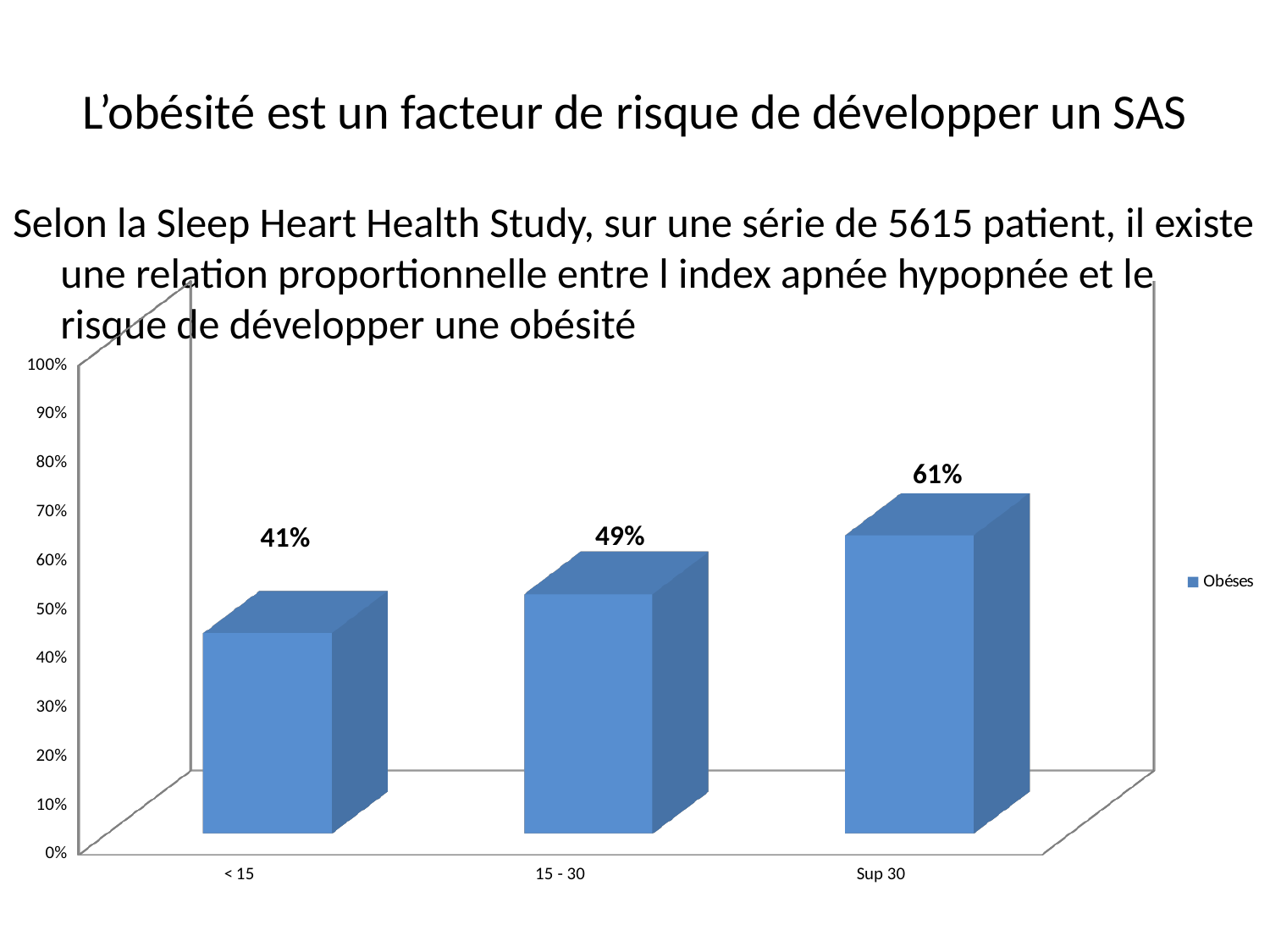
What is the value for the 'Sup 30' category? 61% What is the difference between the values for '15 - 30' and '< 15'? 8% Which category has the lowest value? < 15 How many categories are shown on the x axis? 3 Do the values rise or fall from '< 15' to 'Sup 30'? rise What is the value for the '15 - 30' category? 49% What kind of chart is shown on the slide? bar chart How many series does the legend list? 1 What is the value for the '< 15' category? 41% What is the difference between the values for 'Sup 30' and '< 15'? 20% Which category has the highest value? Sup 30 Which is larger, the value for '15 - 30' or the value for 'Sup 30'? Sup 30